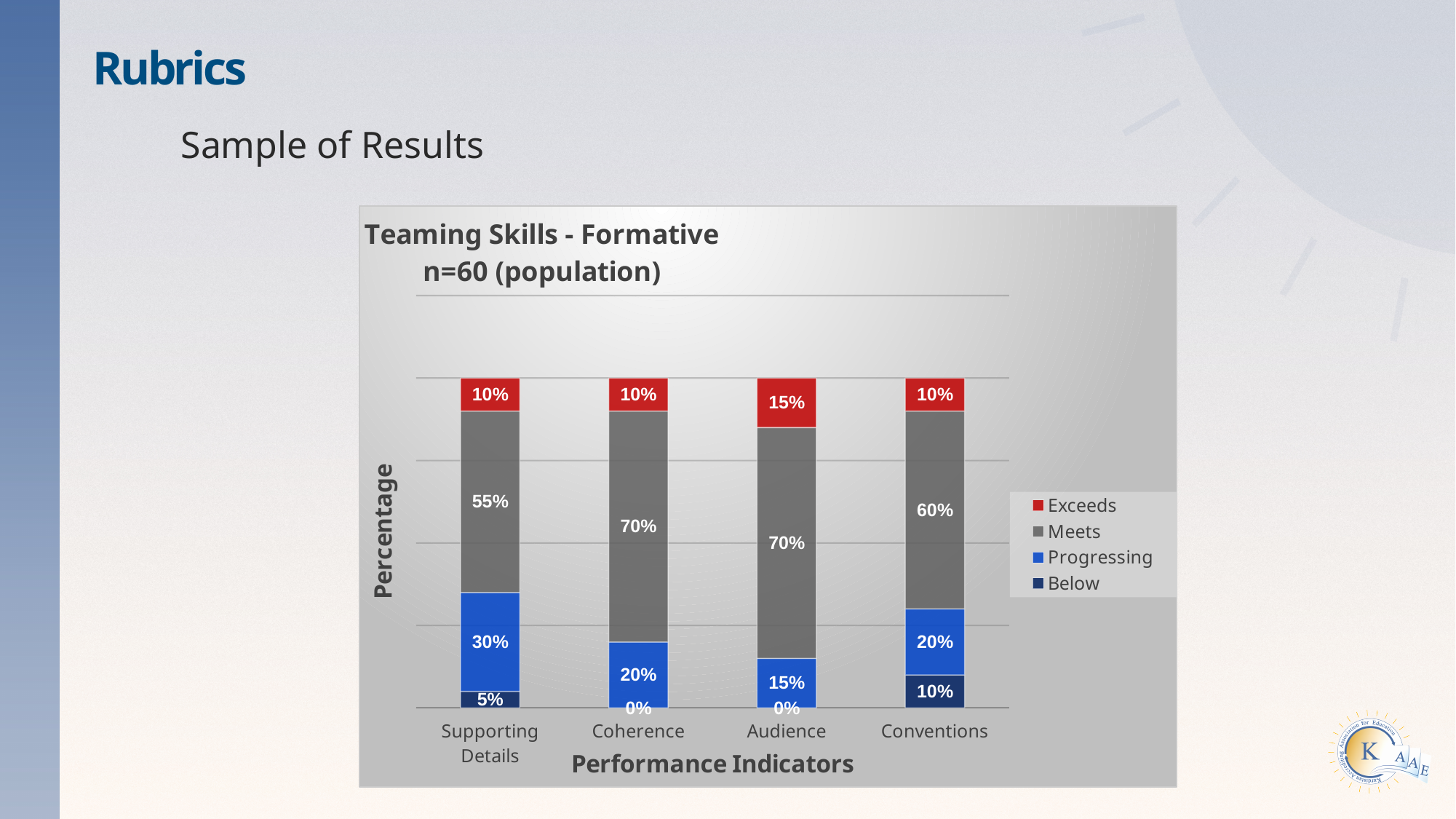
What is the total of the stacked bar for Supporting Details? 100% Which performance indicator has the lowest Meets value? Supporting Details What is the Progressing value for Coherence? 20% How many performance indicators are shown on the x axis? 4 Which performance indicator has the highest Exceeds value? Audience Which is larger: the Meets value for Conventions or the Meets value for Coherence? Coherence What is the Below value for Conventions? 10% What is the Exceeds value for Audience? 15% What is the Meets value for Supporting Details? 55% How many series does the legend list? 4 What type of chart is shown on the slide? Stacked bar chart What is the difference between the Progressing values for Supporting Details and Audience? 15%